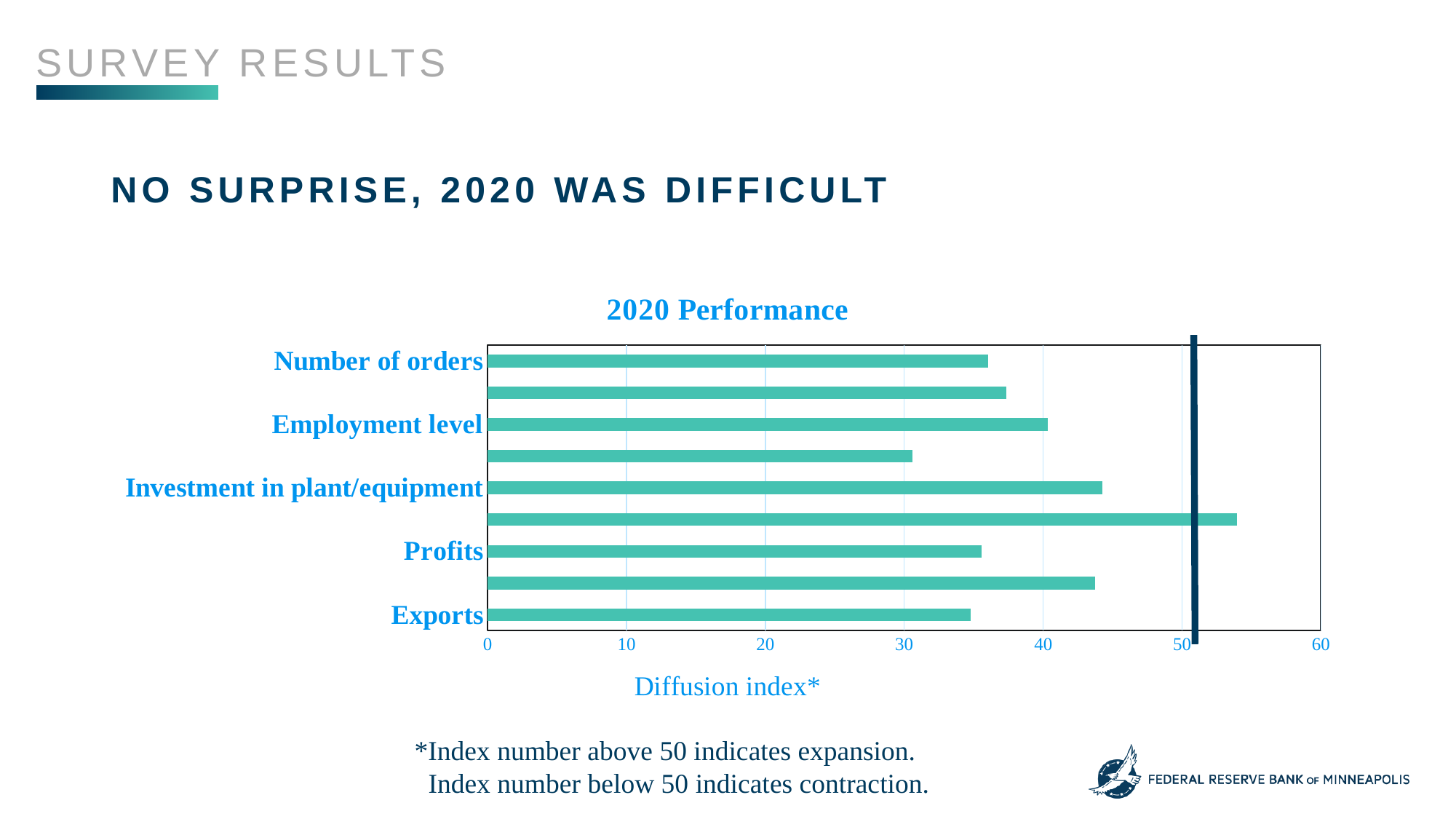
Is the value for Exports greater or less than 40? less What is the label on the horizontal axis of the chart? Diffusion index* Is the value for Investment in plant/equipment greater or less than 50? less Is the value for Investment in plant/equipment greater or less than 40? greater What is the title of the chart? 2020 Performance Which is larger, the value for Investment in plant/equipment or the value for Exports? Investment in plant/equipment How many bars are plotted in the chart? 9 What kind of chart is shown on the slide? bar chart